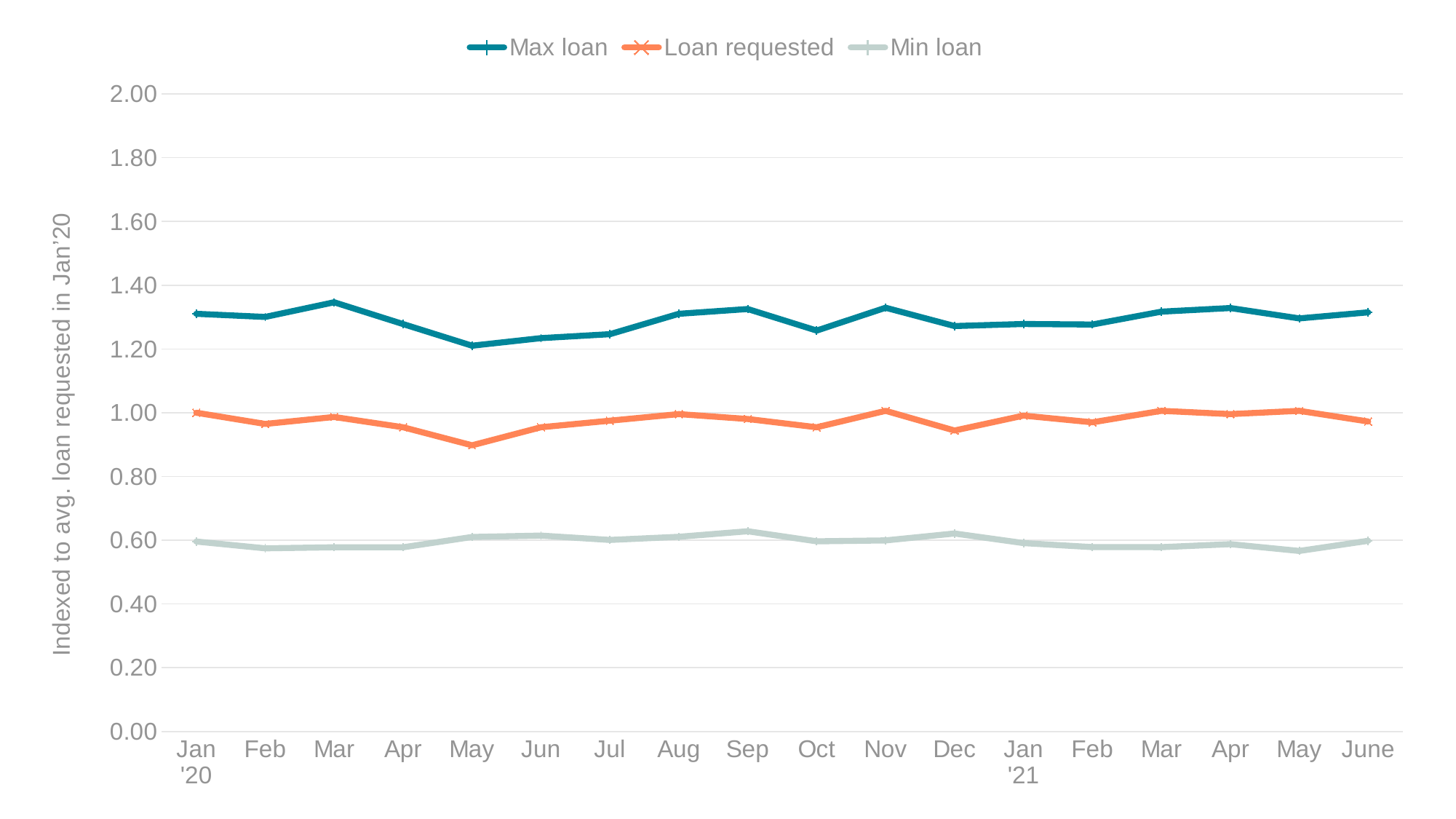
Is the value for Max loan in Mar '20 greater or less than 1.20? greater For the Loan requested series, which month has the larger value, Nov '20 or May '20? Nov '20 Is the value for Min loan in Sep '20 greater or less than 0.60? greater How many series does the legend list? 3 In which month is the Max loan series at its lowest? May '20 Which series is larger in Jan '21, Max loan or Min loan? Max loan Is the value for Max loan in May '20 greater or less than 1.40? less What is the label on the vertical axis? Indexed to avg. loan requested in Jan'20 How many monthly points are plotted along the x axis? 18 In which month is the Loan requested series at its lowest? May '20 What kind of chart is shown on the slide? line chart